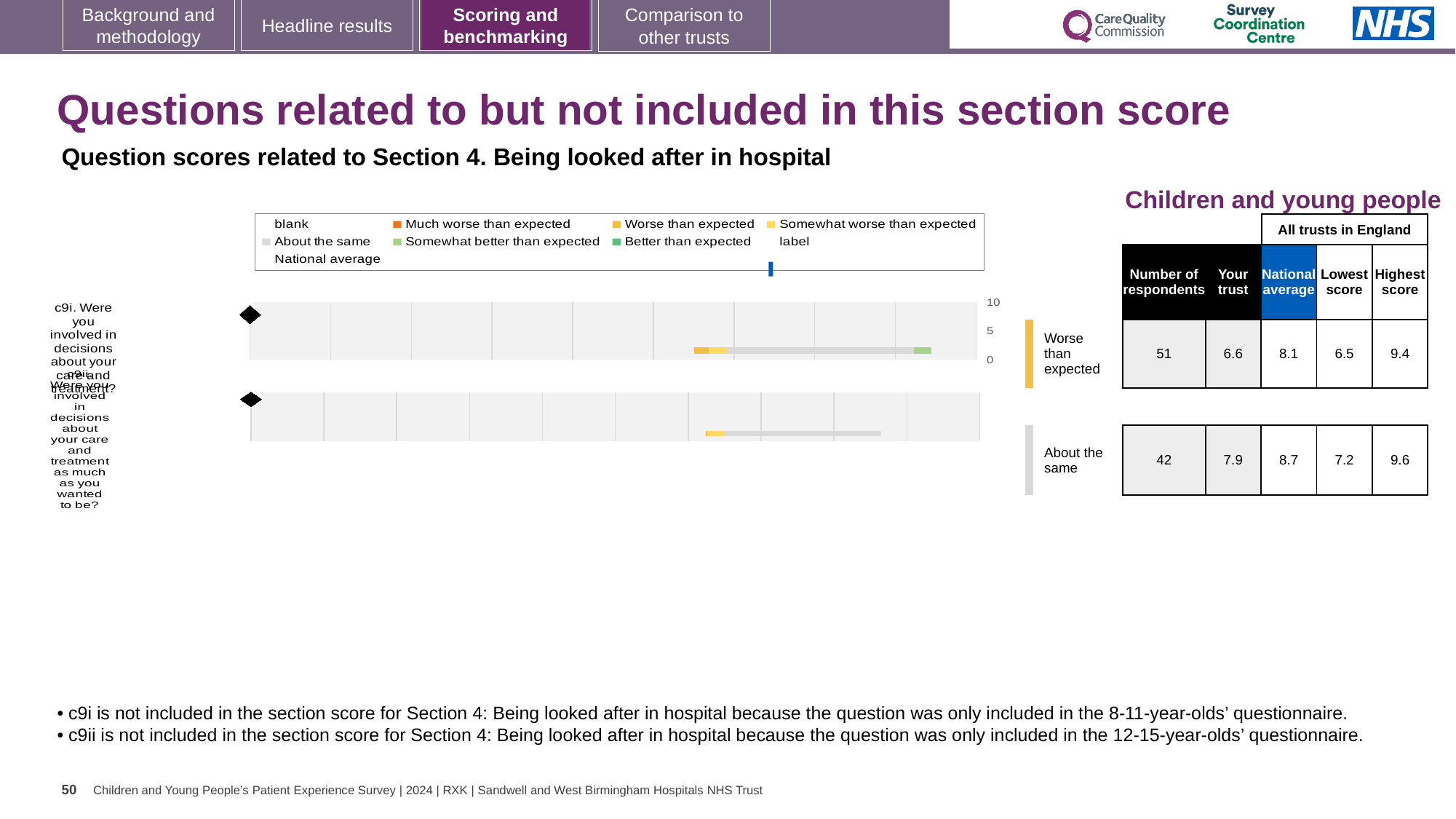
How many questions (categories) are plotted in the chart? 2 What benchmark category is shown for c9ii to the right of the chart? About the same According to the table next to the chart, what is the 'Your trust' score for c9i? 6.6 What is the difference between the national average and the 'Your trust' score for c9i, using the table values? 1.5 Which question has the higher 'Your trust' score in the table, c9i or c9ii? c9ii What benchmark category is shown for c9i to the right of the chart? Worse than expected According to the table next to the chart, what is the national average for c9ii? 8.7 According to the table next to the chart, how many respondents answered c9i? 51 According to the table next to the chart, what is the highest score across all trusts in England for c9ii? 9.6 What kind of chart is shown on the slide? bar chart How many entries does the chart legend list? 9 According to the table next to the chart, what is the lowest score across all trusts in England for c9i? 6.5